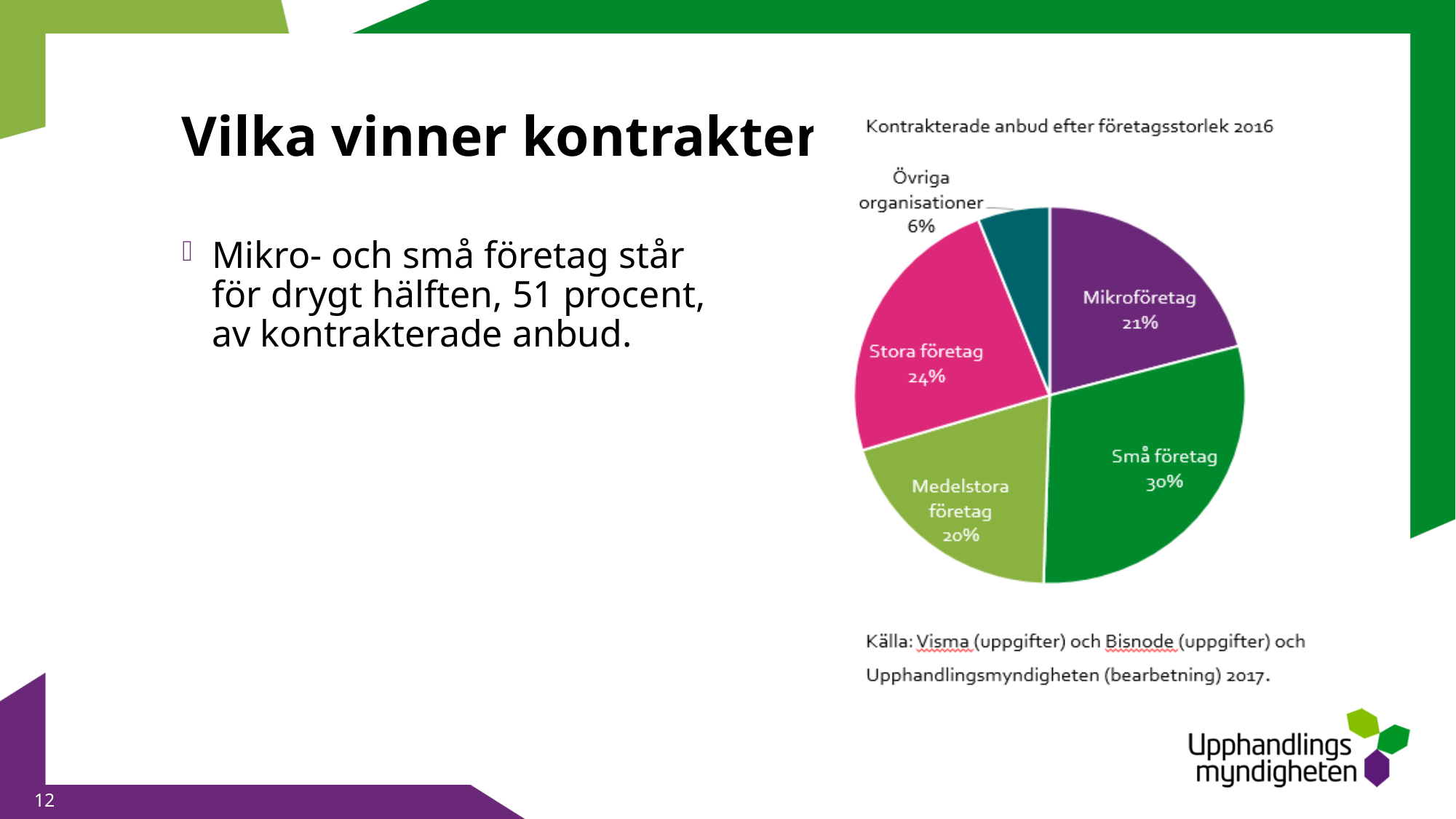
Which category has the smallest slice of the pie? Övriga organisationer How many slices does the pie chart have? 5 What share of the pie is Små företag? 30% Which category has the largest slice of the pie? Små företag What share of the pie is Mikroföretag? 21% What is the difference in percentage points between Små företag and Medelstora företag? 10 What is the title of the chart? Kontrakterade anbud efter företagsstorlek 2016 What type of chart is shown on the slide? Pie chart What share of the pie is Övriga organisationer? 6% What colour is the Stora företag slice? Pink Which is larger, Stora företag or Mikroföretag? Stora företag